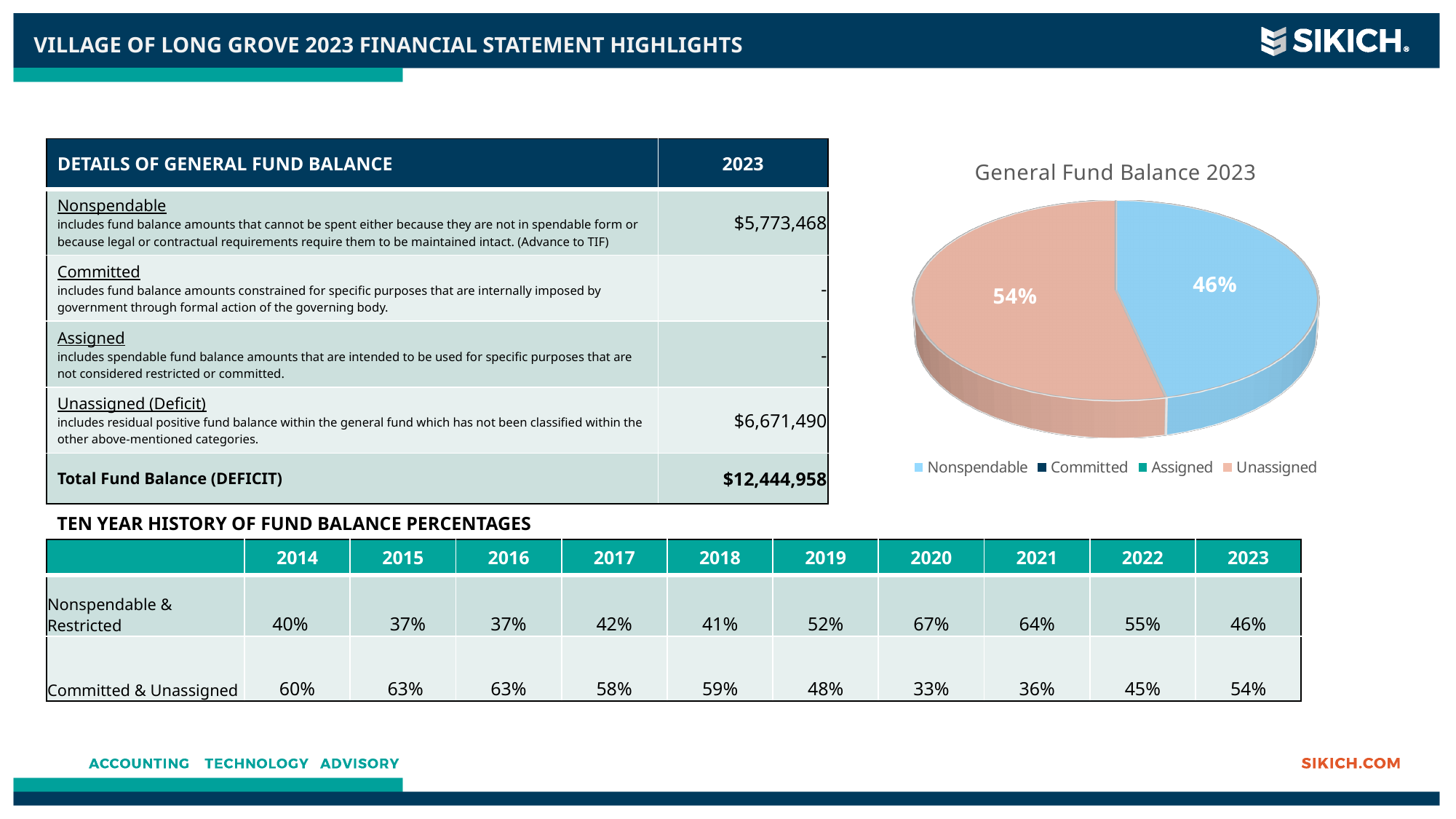
What is the difference in percentage points between the Unassigned and Nonspendable slices? 8 How many slices with data labels are visible in the pie chart? 2 How many entries does the legend of the pie chart list? 4 What colour is the Nonspendable slice in the pie chart? light blue What is the title of the chart on the slide? General Fund Balance 2023 Is the Unassigned slice larger or smaller than the Nonspendable slice? larger Is the share for Nonspendable greater or less than 50%? less Which category has the largest slice in the pie chart? Unassigned Which of the two visible slices is smaller, Nonspendable or Unassigned? Nonspendable What share of the pie does the Unassigned slice represent? 54% What share of the pie does the Nonspendable slice represent? 46% What type of chart is shown on the slide? pie chart